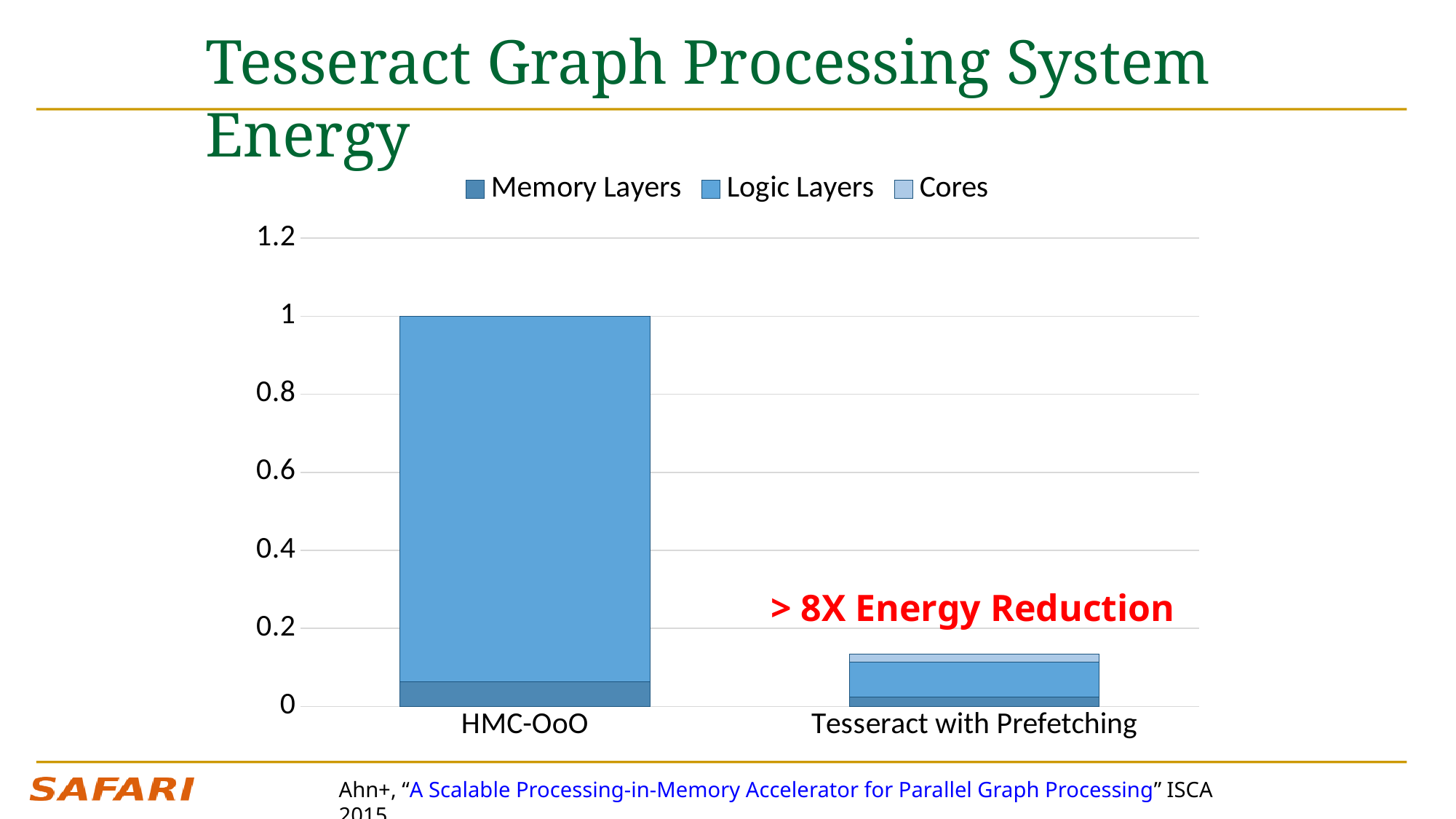
What is the total height of the stacked bar for HMC-OoO? 1 Which category has the lowest total energy in the chart? Tesseract with Prefetching Is the Memory Layers value for HMC-OoO greater or less than 0.2? less Is the total value for Tesseract with Prefetching greater or less than 0.2? less What are the three series listed in the chart's legend? Memory Layers, Logic Layers, Cores Which category has the highest total energy in the chart? HMC-OoO How many categories are shown on the x axis of the chart? 2 Is the total value for HMC-OoO greater or less than 0.8? greater What does the red annotation next to the Tesseract with Prefetching bar say? > 8X Energy Reduction How many series does the chart's legend list? 3 What kind of chart is shown on the slide? bar chart Which has the larger total bar, HMC-OoO or Tesseract with Prefetching? HMC-OoO